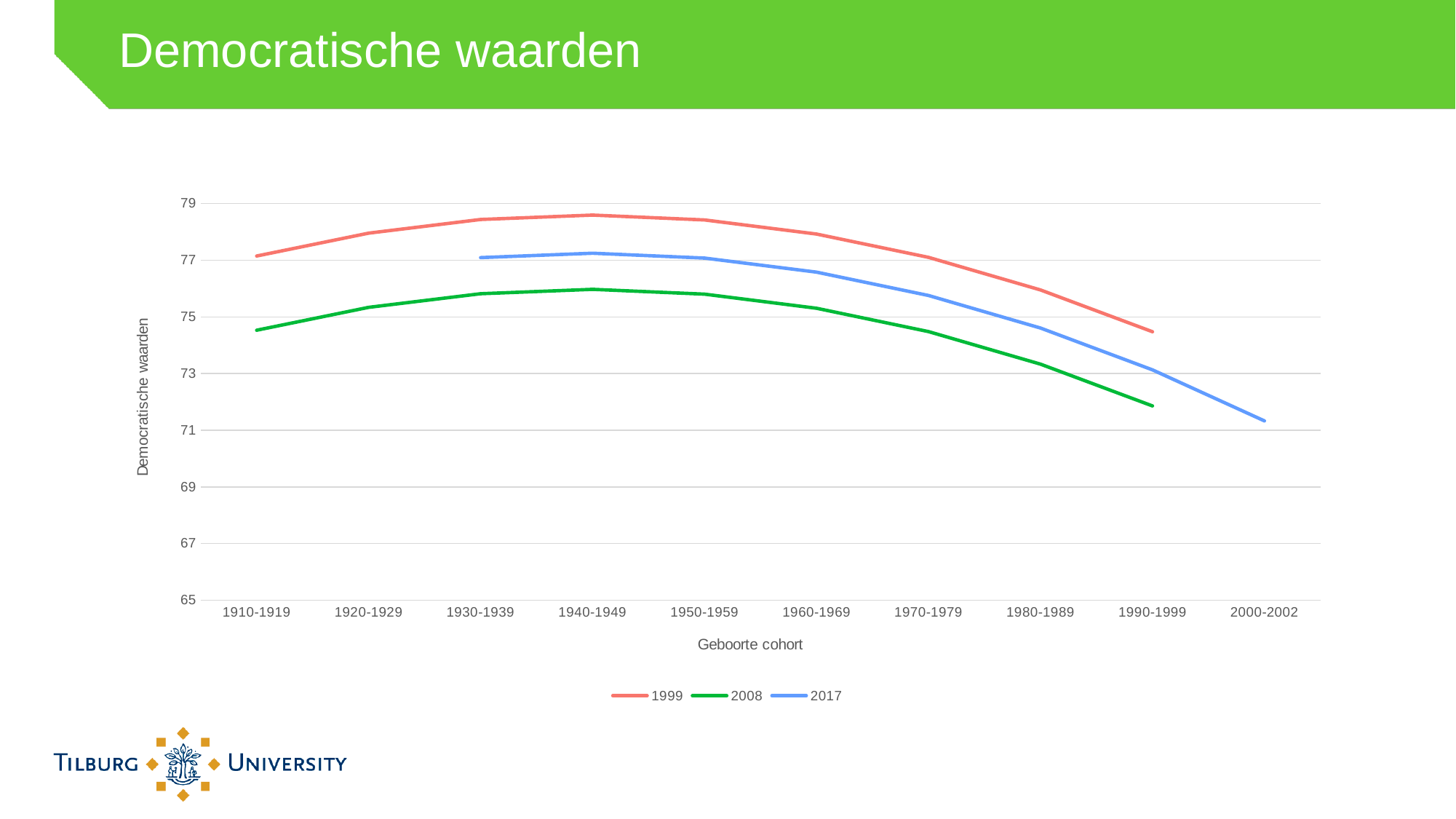
Is the value for the 2008 series at 1990-1999 greater or less than 73? less At the 1960-1969 cohort, which series has the higher value, 2017 or 2008? 2017 How many birth cohorts are shown on the x axis? 10 For the 2008 series, which birth cohort has the lowest value? 1990-1999 Is the value for the 1999 series at 1940-1949 greater or less than 77? greater Do the values of the 1999 series rise or fall from 1940-1949 to 1990-1999? fall Is the value for the 2017 series at 2000-2002 greater or less than 73? less At the 1940-1949 cohort, which series has the higher value, 1999 or 2008? 1999 How many series does the legend list? 3 What kind of chart is shown on the slide? line chart Which series is the only one with a value plotted for the 2000-2002 cohort? 2017